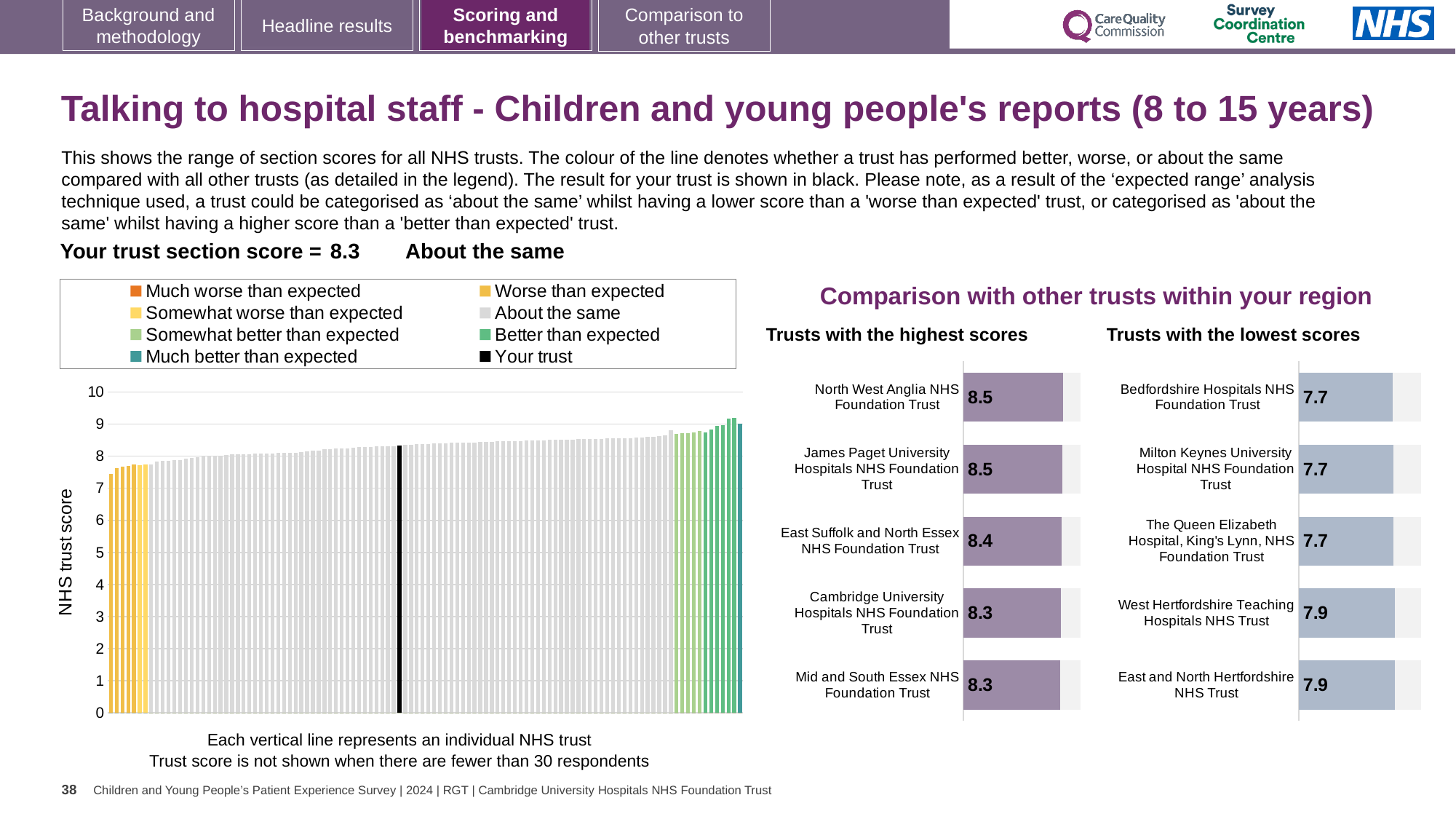
How many entries does the legend of the large 'NHS trust score' chart list? 8 In the 'Trusts with the lowest scores' chart, what is the score for Bedfordshire Hospitals NHS Foundation Trust? 7.7 In the large 'NHS trust score' chart on the left, is the value of the leftmost bar greater or less than 8? less In the 'Trusts with the highest scores' chart, what is the score for North West Anglia NHS Foundation Trust? 8.5 In the large 'NHS trust score' chart on the left, do the bar values rise or fall from left to right? Rise How many trusts are listed in the 'Trusts with the highest scores' chart? 5 How many trusts are listed in the 'Trusts with the lowest scores' chart? 5 In the 'Trusts with the highest scores' chart, what is the difference between the scores of North West Anglia NHS Foundation Trust and Cambridge University Hospitals NHS Foundation Trust? 0.2 What kind of chart is the large 'NHS trust score' chart on the left of the slide? Bar chart In the 'Trusts with the lowest scores' chart, which has the larger score: West Hertfordshire Teaching Hospitals NHS Trust or Bedfordshire Hospitals NHS Foundation Trust? West Hertfordshire Teaching Hospitals NHS Trust In the 'Trusts with the lowest scores' chart, what is the score for West Hertfordshire Teaching Hospitals NHS Trust? 7.9 In the 'Trusts with the highest scores' chart, what is the score for East Suffolk and North Essex NHS Foundation Trust? 8.4